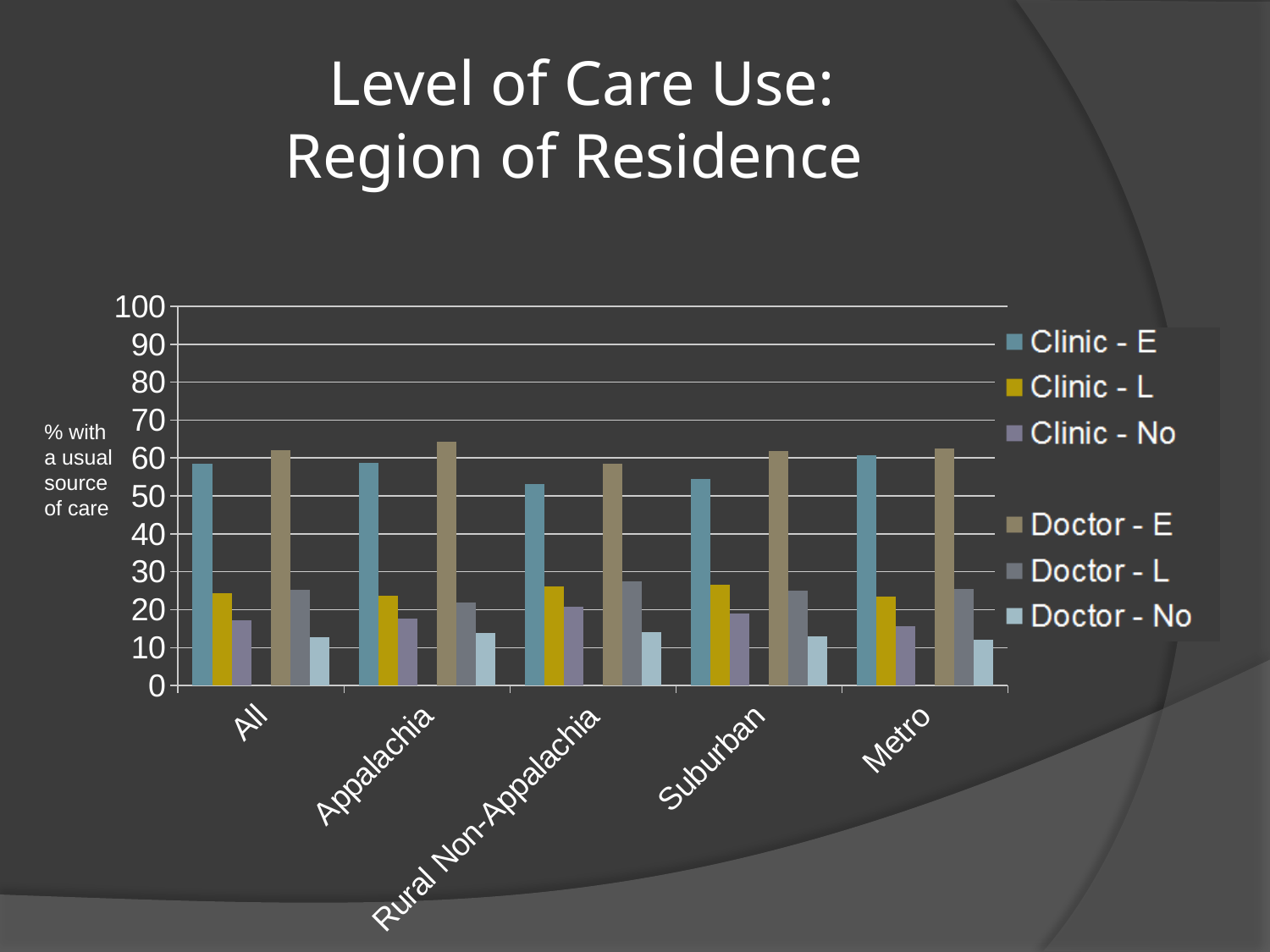
What kind of chart is shown on the slide? bar chart Is the value for Doctor - L in the Rural Non-Appalachia category greater or less than 20? greater In the All category, which series has the lowest value? Doctor - No In the Suburban category, which is larger: Clinic - L or Doctor - No? Clinic - L How many region categories are shown on the x axis? 5 Is the value for Doctor - No in the Metro category greater or less than 20? less What is the label on the vertical axis of the chart? % with a usual source of care Is the value for Clinic - E in the All category greater or less than 50? greater In the Rural Non-Appalachia category, which series has the highest value? Doctor - E How many series does the legend list? 6